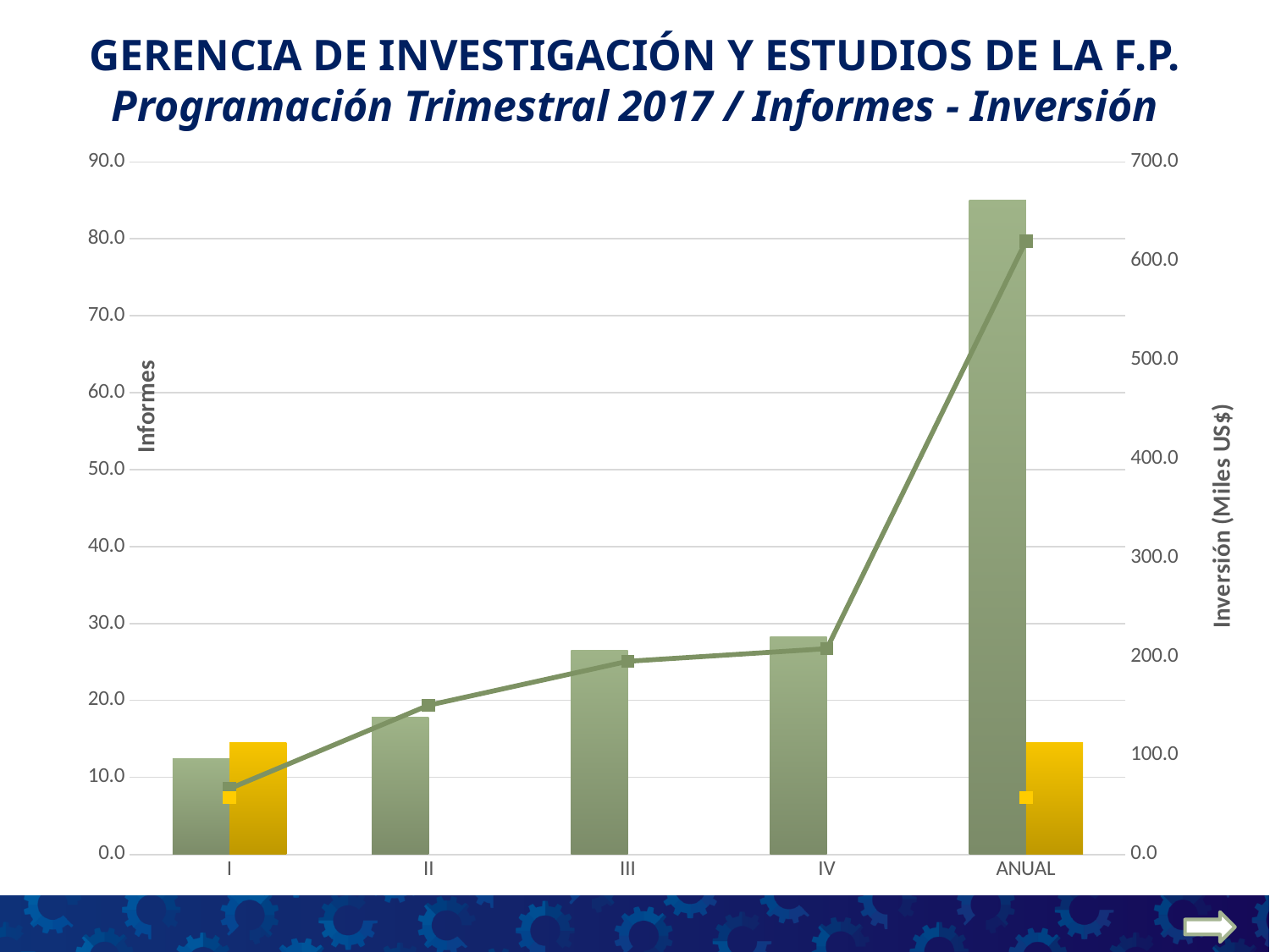
What is the title of the right vertical axis? Inversión (Miles US$) Is the green bar for ANUAL greater or less than 80.0 on the left axis? greater What is the title of the left vertical axis? Informes Is the green line value for ANUAL greater or less than 600.0 on the right axis? greater Is the green line value for I greater or less than 100.0 on the right axis? less Which category has the shortest green bar? I Which category has the tallest green bar? ANUAL What kind of chart is shown on the slide? A combined bar and line chart Which has a taller green bar, II or III? III Do the green bars rise or fall from I to IV? rise How many categories are shown on the x axis? 5